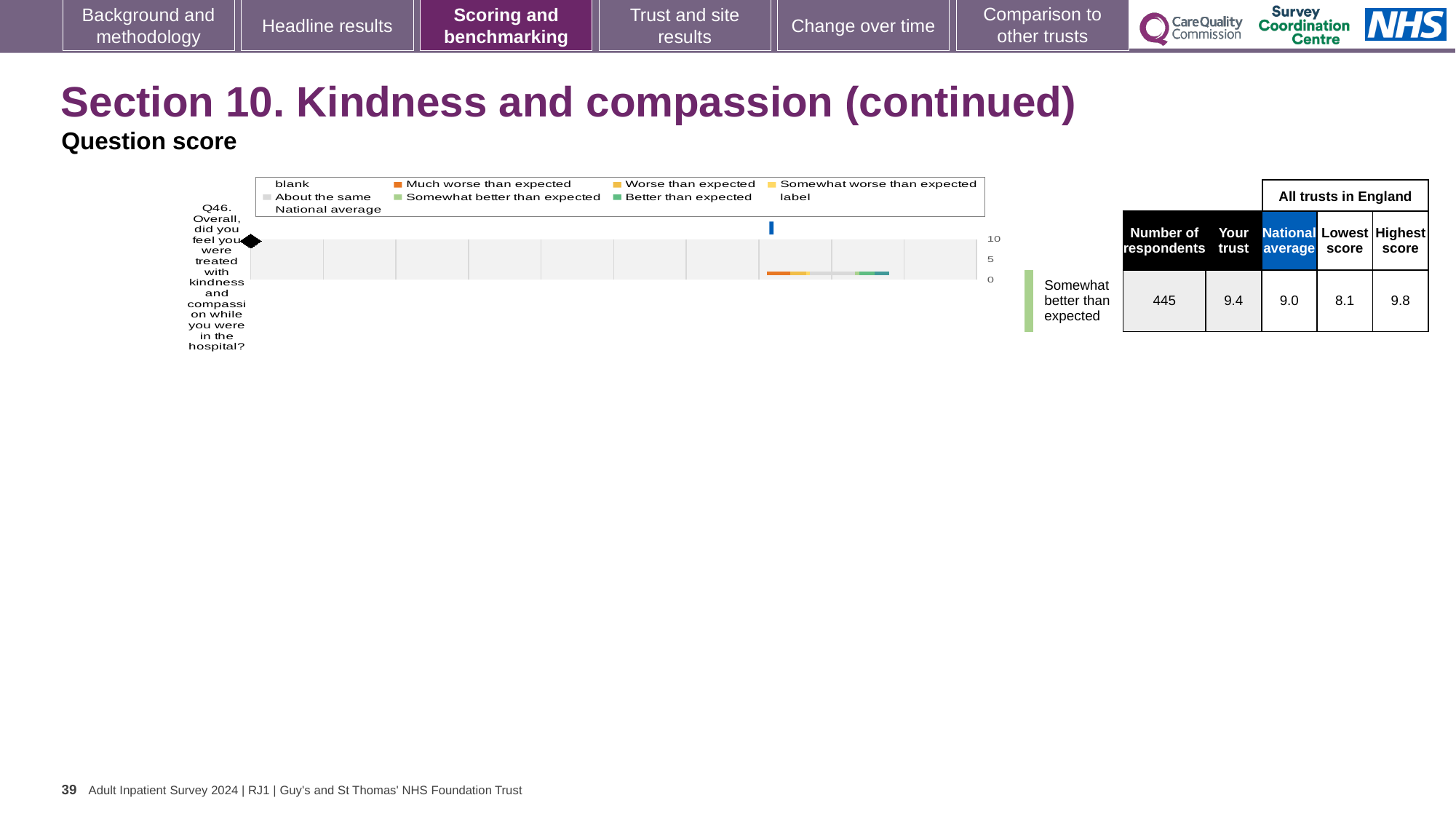
What is the lowest score among all trusts in England for Q46? 8.1 What is the difference between the 'Your trust' score and the national average for Q46? 0.4 Which is larger for Q46, the 'Your trust' score or the national average? Your trust What kind of chart is shown on the slide? bar chart How many respondents answered Q46? 445 What is the difference between the highest and lowest scores for Q46 across all trusts in England? 1.7 What is the 'Your trust' score for Q46? 9.4 What is the highest score among all trusts in England for Q46? 9.8 How many survey questions are plotted in the chart? 1 What is the national average score for Q46? 9.0 What is the highest tick value shown on the chart's score axis? 10 Which benchmark category is Q46 rated as on the slide? Somewhat better than expected